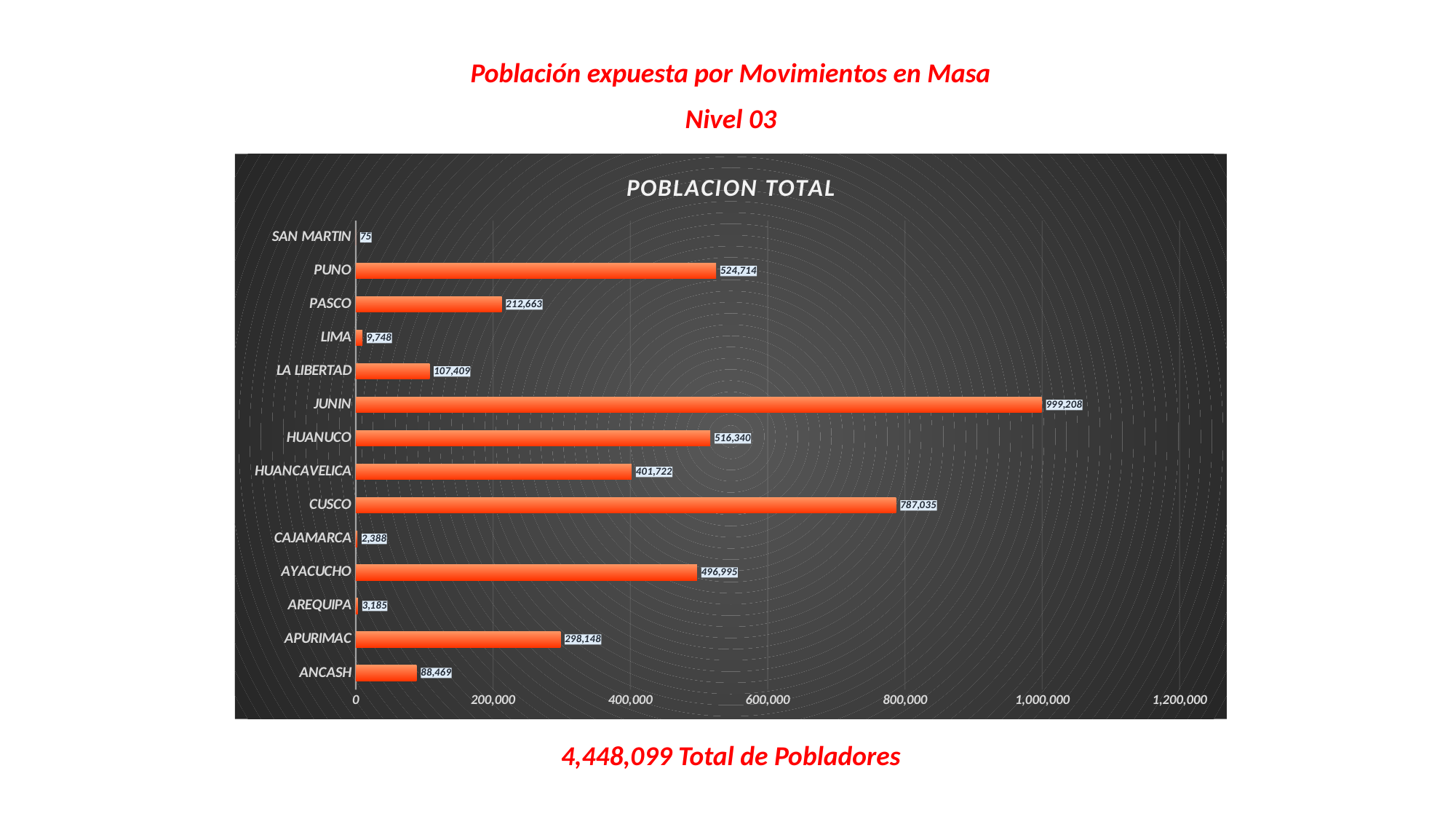
How many categories are shown in the chart? 14 What is the value for LIMA? 9,748 What is the value for HUANCAVELICA? 401,722 Which category has the highest value? JUNIN What type of chart is shown on the slide? Bar chart Is the value for CUSCO greater or less than 600,000? greater Which category has the lowest value? SAN MARTIN What is the value for JUNIN? 999,208 What is the title of the chart? POBLACION TOTAL What total number of inhabitants is stated below the chart? 4,448,099 Which has a larger value, CUSCO or HUANCAVELICA? CUSCO What is the difference between the values for JUNIN and CUSCO? 212,173